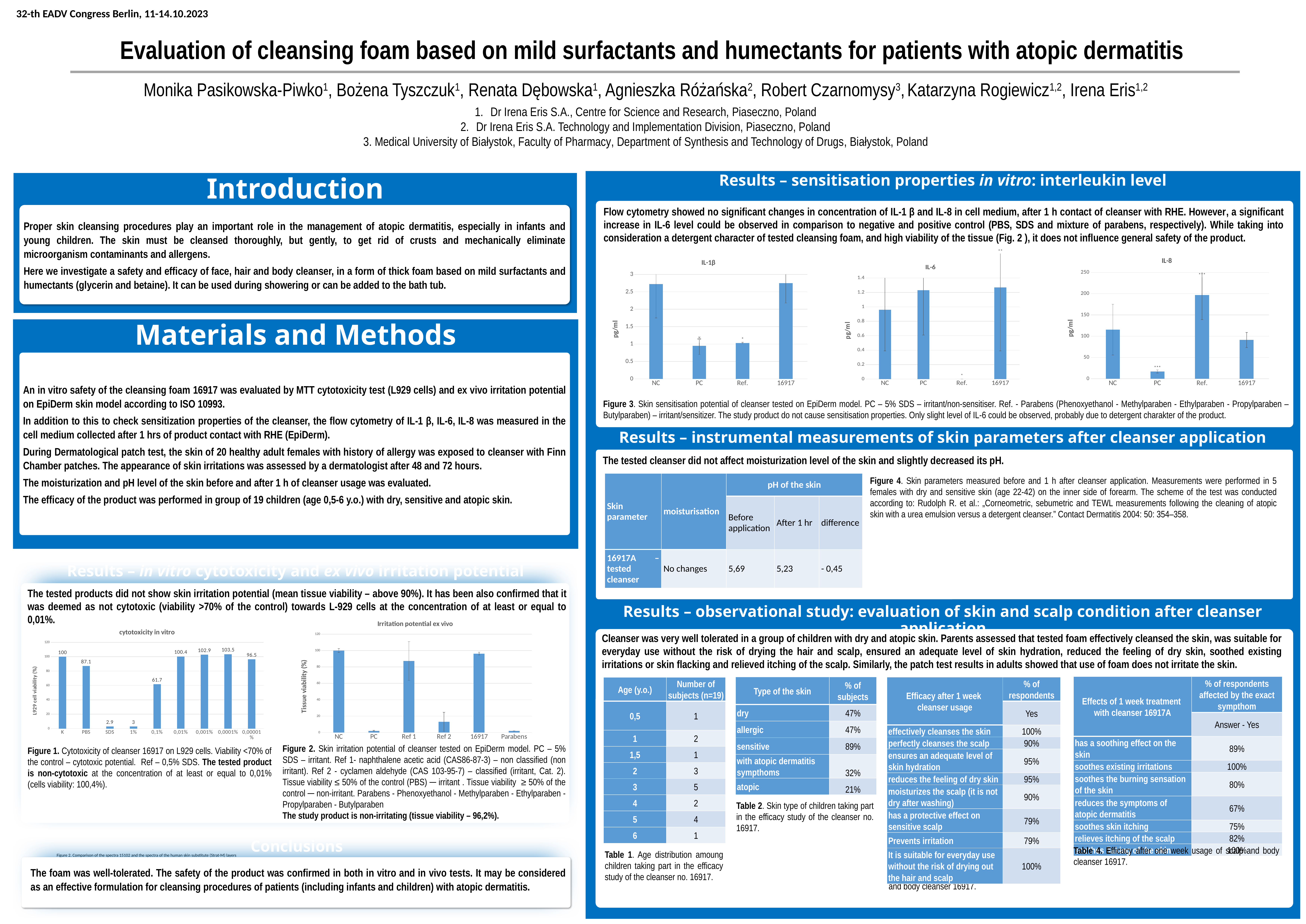
In the 'cytotoxicity in vitro' chart, which category has the highest viability? 0.0001% In the 'cytotoxicity in vitro' chart, how many categories are shown on the x axis? 9 In the 'Irritation potential ex vivo' chart, is the tissue viability for Ref 2 greater or less than 40? less In the 'Irritation potential ex vivo' chart, which is larger, the value for Ref 1 or the value for Ref 2? Ref 1 In the 'cytotoxicity in vitro' chart, which category has the lowest viability? SDS In the 'cytotoxicity in vitro' chart, what is the value for the 0.1% concentration? 61.7 In the 'cytotoxicity in vitro' chart, what is the L929 cell viability for PBS? 87.1 In the IL-8 chart, which category has the highest value? Ref. In the 'cytotoxicity in vitro' chart, what is the difference between the values for 0.001% and 0.01%? 2.5 In the 'Irritation potential ex vivo' chart, is the tissue viability for 16917 greater or less than 80? greater What type of chart is the IL-6 chart? bar chart In the IL-8 chart, is the value for PC greater or less than 50? less